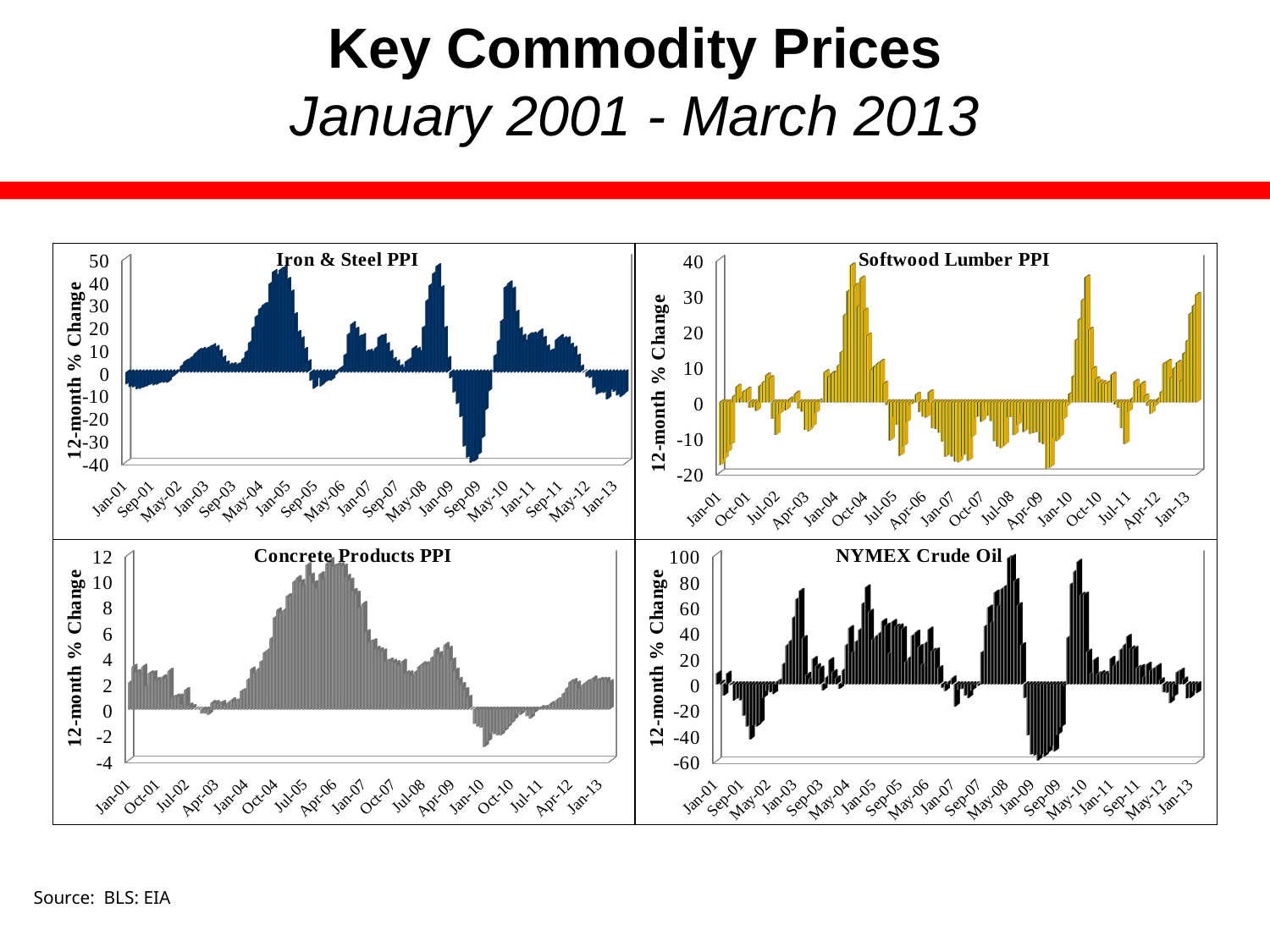
In the NYMEX Crude Oil chart, is the lowest value (around Jan-09) greater or less than -40? less What is the title of the chart in the bottom-left position of the slide? Concrete Products PPI How many charts are shown on the slide? 4 In the Softwood Lumber PPI chart, is the highest value greater or less than 30? greater In the NYMEX Crude Oil chart, is the highest value greater or less than 80? greater What kind of chart is the Iron & Steel PPI chart? Bar chart Which of the four charts reaches the largest 12-month % change? NYMEX Crude Oil In the NYMEX Crude Oil chart, do the values rise or fall between May-08 and Jan-09? fall What is the y-axis label on the NYMEX Crude Oil chart? 12-month % Change